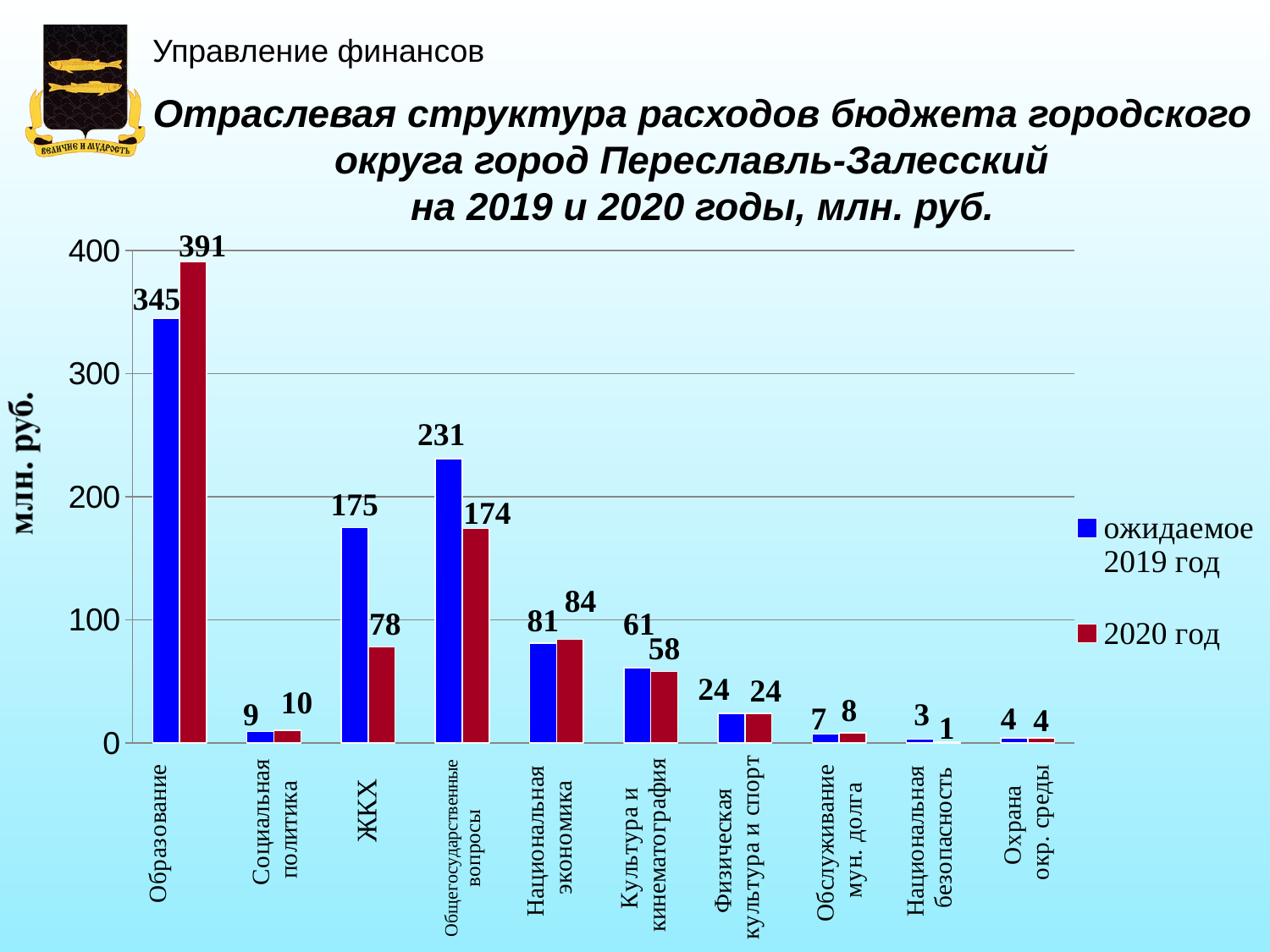
How many series does the legend list? 2 Which is larger for Национальная экономика: the ожидаемое 2019 год value or the 2020 год value? 2020 год What is the value for Общегосударственные вопросы in the 2020 год series? 174 Which category has the lowest value in the 2020 год series? Национальная безопасность What is the value for Образование in the 2020 год series? 391 What kind of chart is shown on the slide? bar chart Which category has the highest value in the ожидаемое 2019 год series? Образование How many categories are shown on the x axis? 10 What is the value for ЖКХ in the ожидаемое 2019 год series? 175 Is the value for Общегосударственные вопросы in the ожидаемое 2019 год series greater or less than 200? greater What is the label of the y axis? млн. руб. What is the difference between the 2019 and 2020 values for ЖКХ? 97